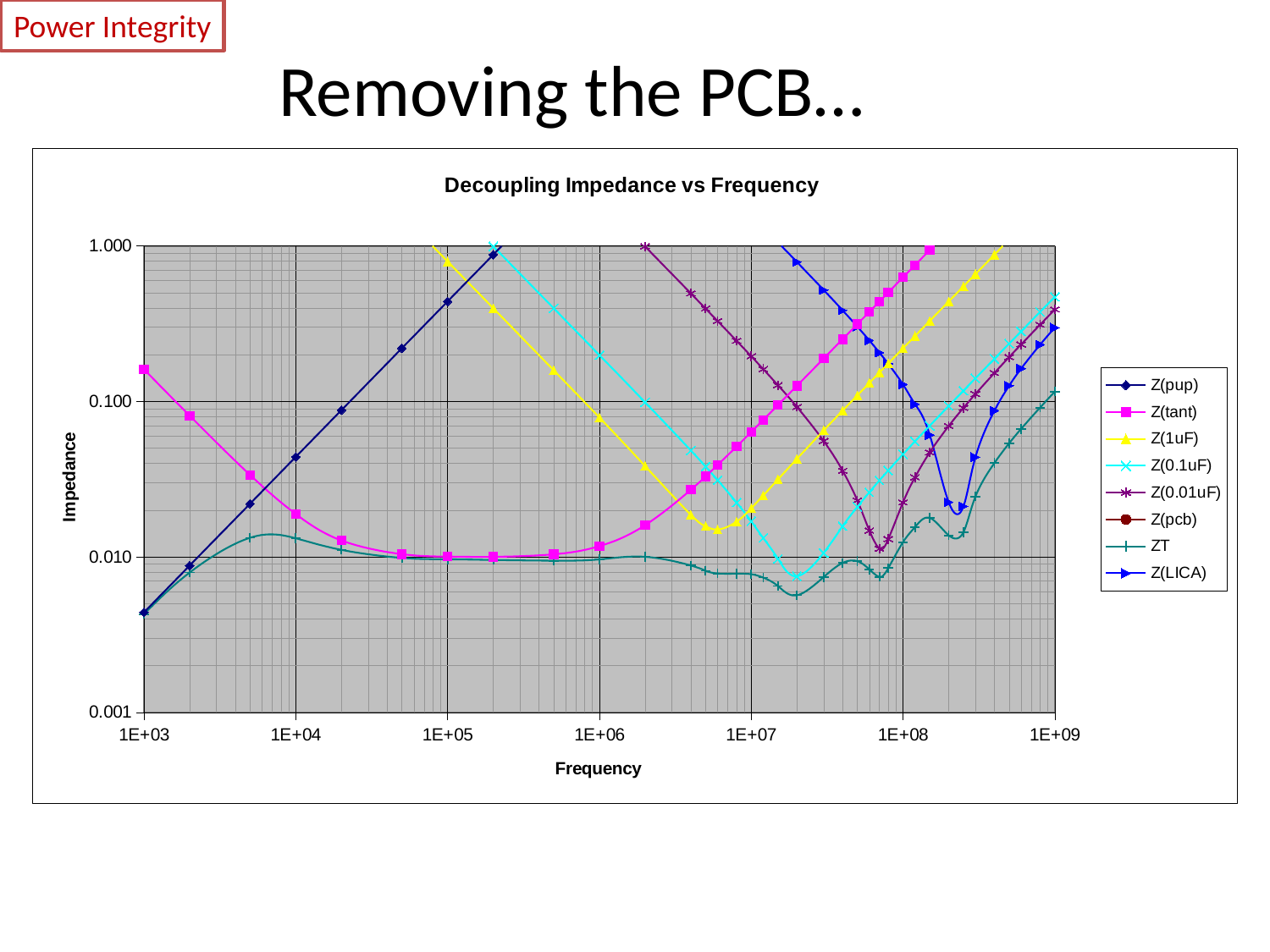
What is the label of the vertical axis? Impedance At 1E+03, which series has the larger value, Z(tant) or Z(pup)? Z(tant) Is the value of ZT at 1E+07 greater or less than 0.010? less Does Z(tant) rise or fall as frequency increases from 1E+03 to 1E+05? fall How many labelled tick marks are on the Frequency axis? 7 Is the value of Z(pup) at 1E+04 greater or less than 0.100? less What is the title of the chart? Decoupling Impedance vs Frequency Is the value of Z(tant) at 1E+03 greater or less than 0.100? greater How many series does the legend list? 8 Does Z(pup) rise or fall as frequency increases from 1E+03 to 1E+05? rise What kind of chart is shown on the slide? line chart